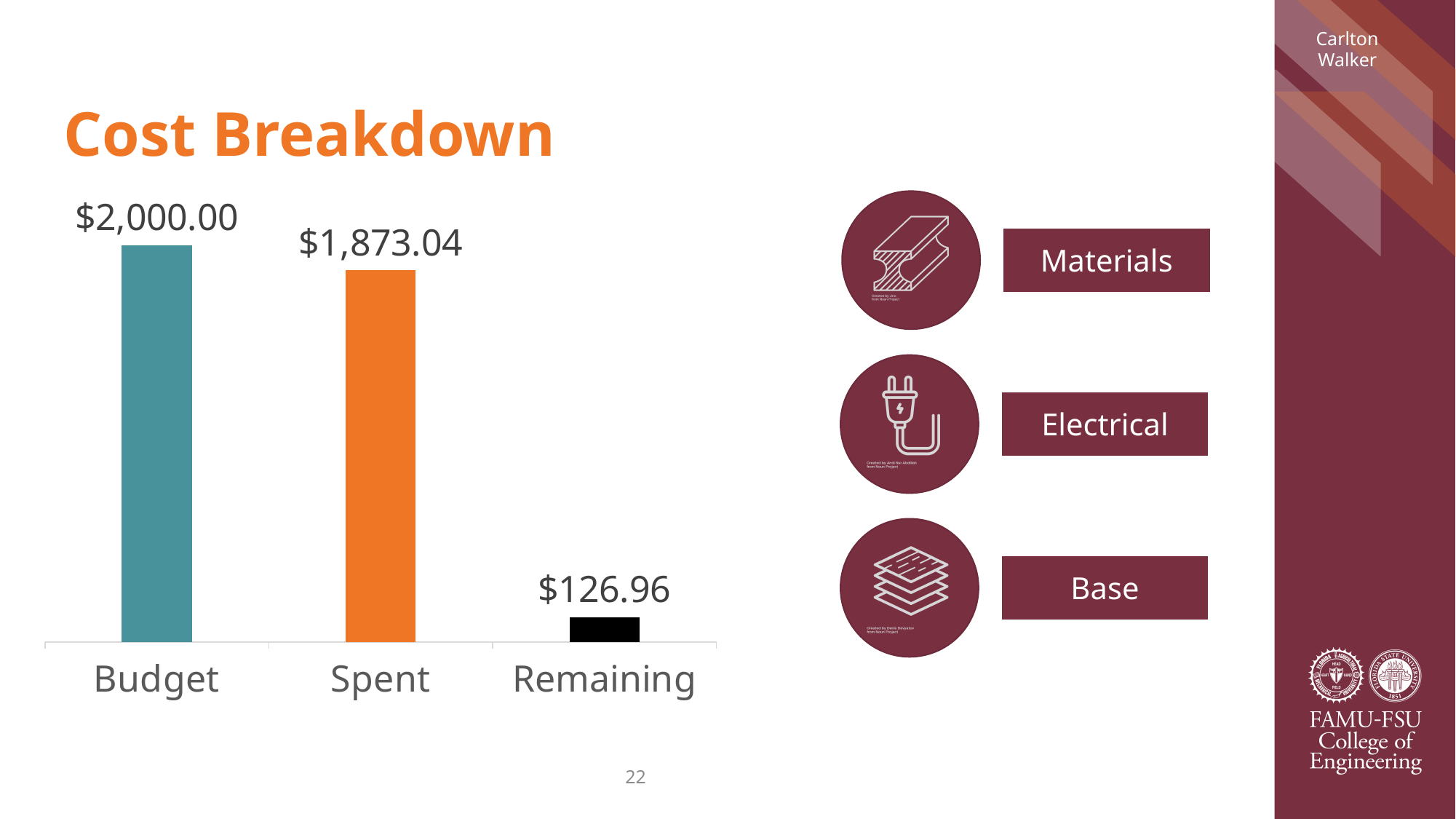
Do the values rise or fall from left to right across the categories? Fall How many categories are shown in the chart? 3 What is the value of the Remaining bar? $126.96 Which is larger, the Spent value or the Remaining value? Spent What colour is the Spent bar? Orange Which category has the lowest value? Remaining What is the difference between the Budget and Spent values? $126.96 What is the value of the Budget bar? $2,000.00 Which category has the highest value? Budget What kind of chart is shown on the slide? Bar chart What is the value of the Spent bar? $1,873.04 What is the difference between the Spent and Remaining values? $1,746.08